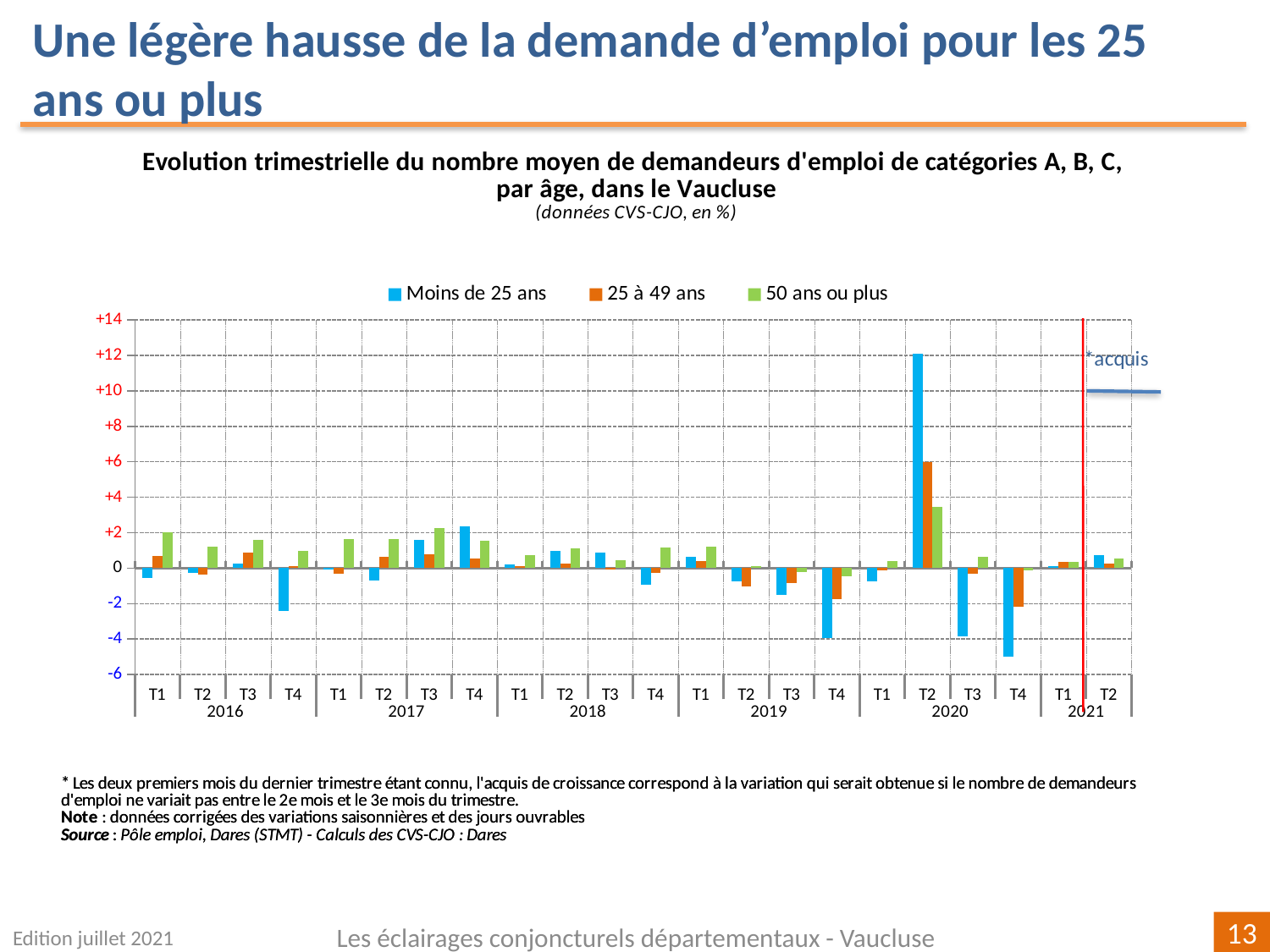
Which series is shown in blue in the legend? Moins de 25 ans In which quarter does the 'Moins de 25 ans' series reach its highest value? T2 2020 In which quarter does the 'Moins de 25 ans' series reach its lowest value? T4 2020 How many quarters are shown along the x axis? 22 Is the value for 'Moins de 25 ans' in T2 2020 greater or less than +10? greater Is the value for '25 à 49 ans' in T2 2020 greater or less than +4? greater What kind of chart is shown on the slide? bar chart What is the unit indicated under the chart title? en % Is the value for 'Moins de 25 ans' in T4 2019 greater or less than -2? less In T2 2020, which series has the larger value: 'Moins de 25 ans' or '25 à 49 ans'? Moins de 25 ans How many series does the legend list? 3